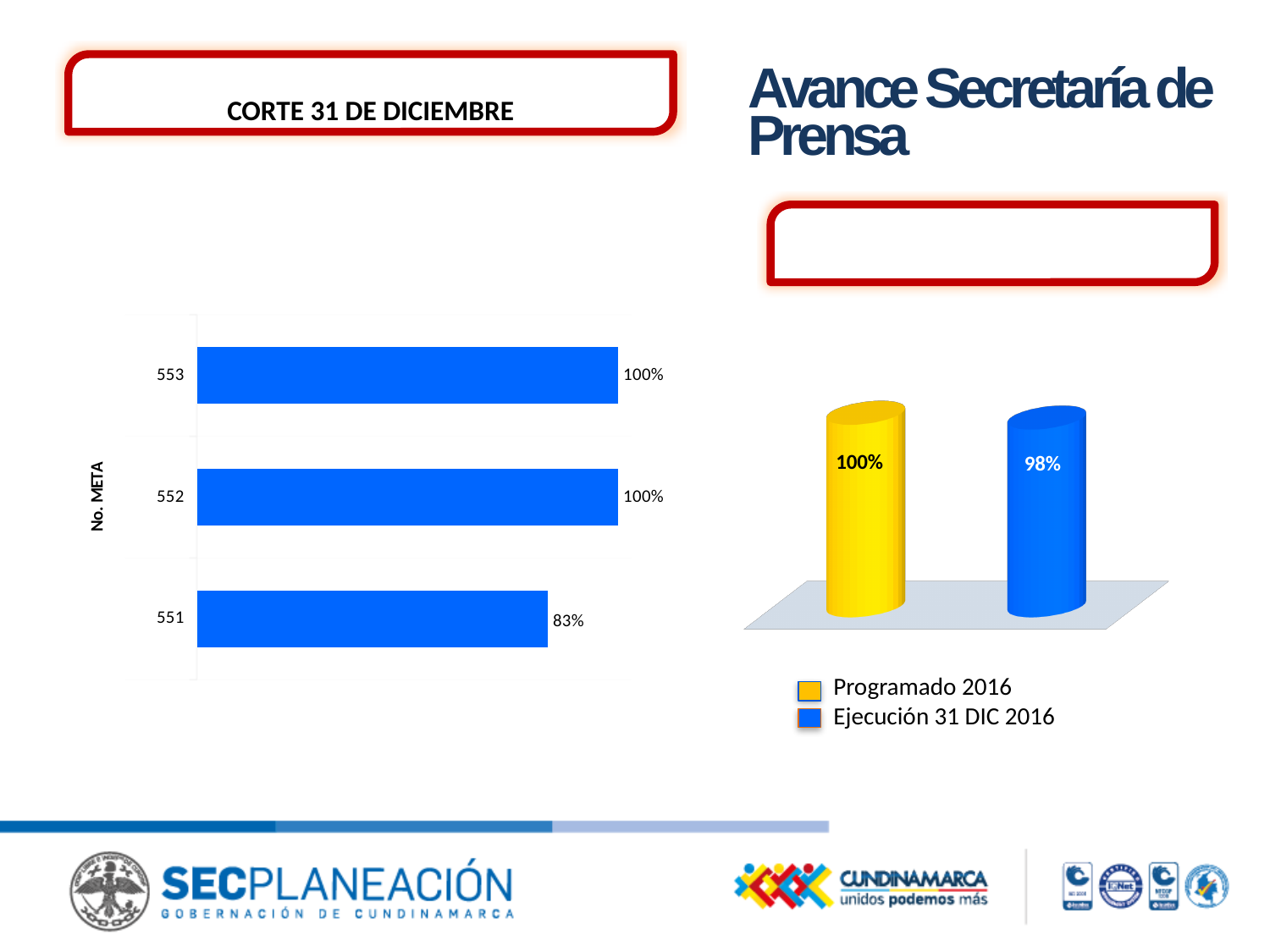
In the right chart, what is the value for Ejecución 31 DIC 2016? 98% In the left bar chart, which is larger, the value for meta 552 or meta 551? 552 In the right chart, what is the value for Programado 2016? 100% In the left bar chart, which meta has the lowest value? 551 In the left bar chart, what is the value for meta 552? 100% In the left bar chart, what is the difference between the values for meta 553 and meta 551? 17% In the right chart, what is the difference between Programado 2016 and Ejecución 31 DIC 2016? 2% How many metas are shown in the left bar chart? 3 In the right chart, what colour is the bar for Programado 2016? yellow How many entries does the legend of the right chart list? 2 What kind of chart is the left chart? bar chart In the left bar chart, what is the value for meta 551? 83%